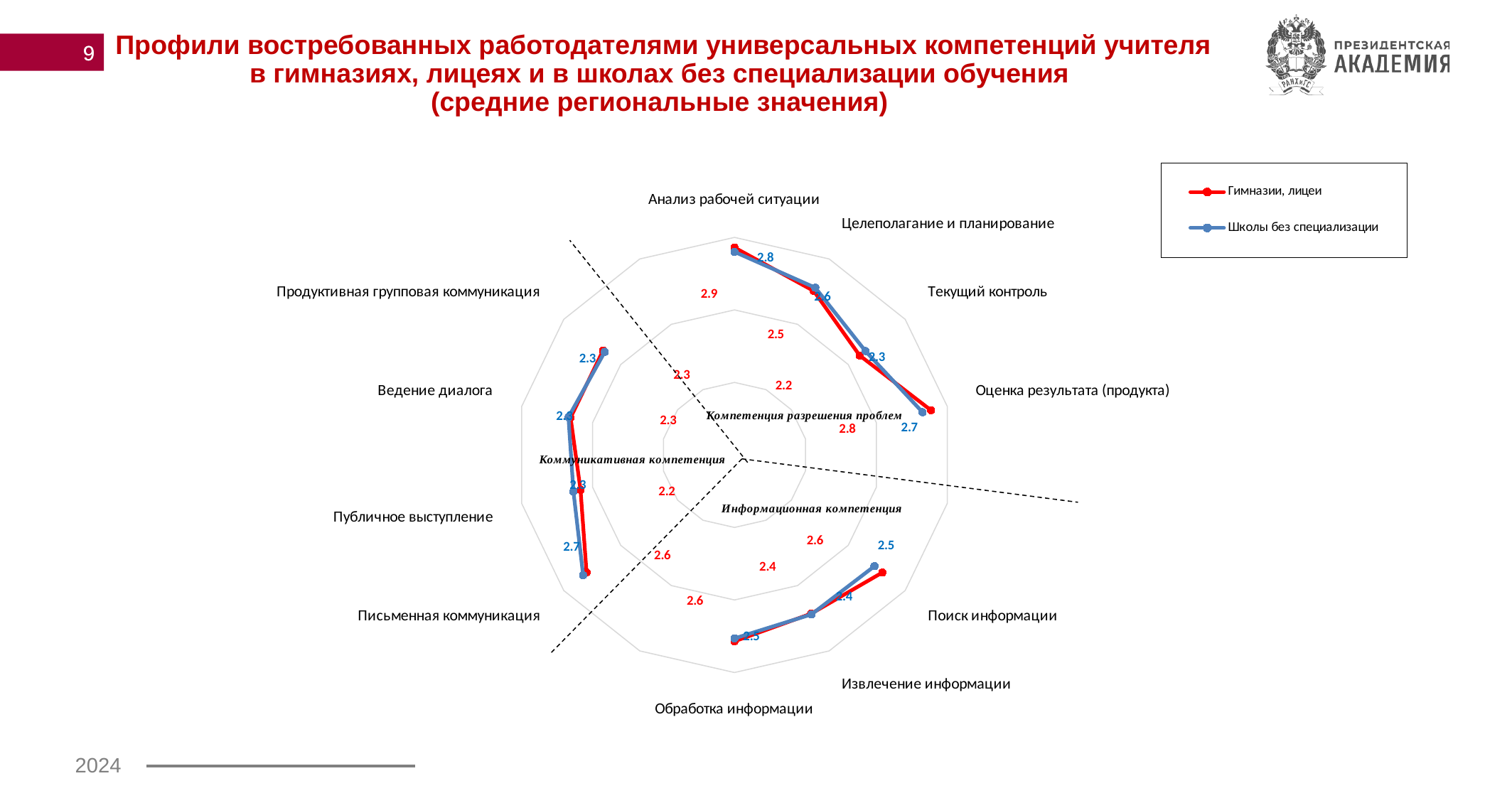
What is the value for Оценка результата (продукта) in the Школы без специализации series? 2.7 Which colour represents the Гимназии, лицеи series? red Which category has the highest value in the Школы без специализации series? Анализ рабочей ситуации What is the value for Текущий контроль in the Школы без специализации series? 2.3 What kind of chart is shown on the slide? radar chart What is the value for Извлечение информации in the Школы без специализации series? 2.4 What is the value for Письменная коммуникация in the Школы без специализации series? 2.7 In the Школы без специализации series, which is larger: Анализ рабочей ситуации or Текущий контроль? Анализ рабочей ситуации What is the value for Анализ рабочей ситуации in the Школы без специализации series? 2.8 What is the name of the second series in the legend? Школы без специализации How many series does the legend list? 2 In the Школы без специализации series, what is the difference between Анализ рабочей ситуации and Текущий контроль? 0.5